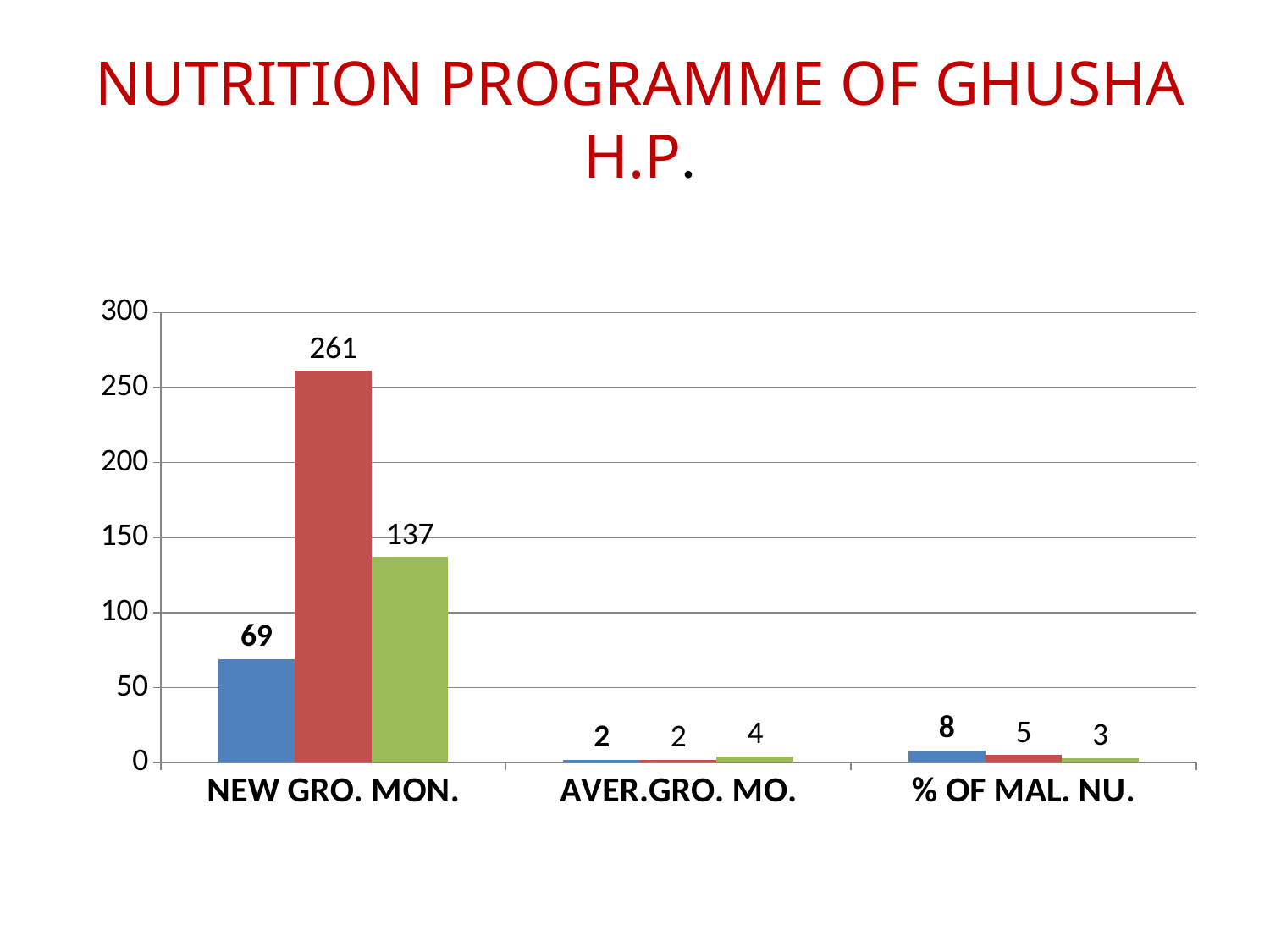
Which is larger for % OF MAL. NU., the blue bar or the red bar? The blue bar Which bar has the highest value in the whole chart? The red bar for NEW GRO. MON. (261) What is the difference between the red and green bars for NEW GRO. MON.? 124 How many categories are shown on the x axis? 3 What is the value of the green bar for NEW GRO. MON.? 137 What kind of chart is shown on the slide? Bar chart Which bar has the lowest value for % OF MAL. NU.? The green bar (3) What is the value of the blue bar for NEW GRO. MON.? 69 What is the value of the green bar for AVER.GRO. MO.? 4 What is the title of the slide? NUTRITION PROGRAMME OF GHUSHA H.P. What is the value of the blue bar for % OF MAL. NU.? 8 What is the value of the red bar for NEW GRO. MON.? 261